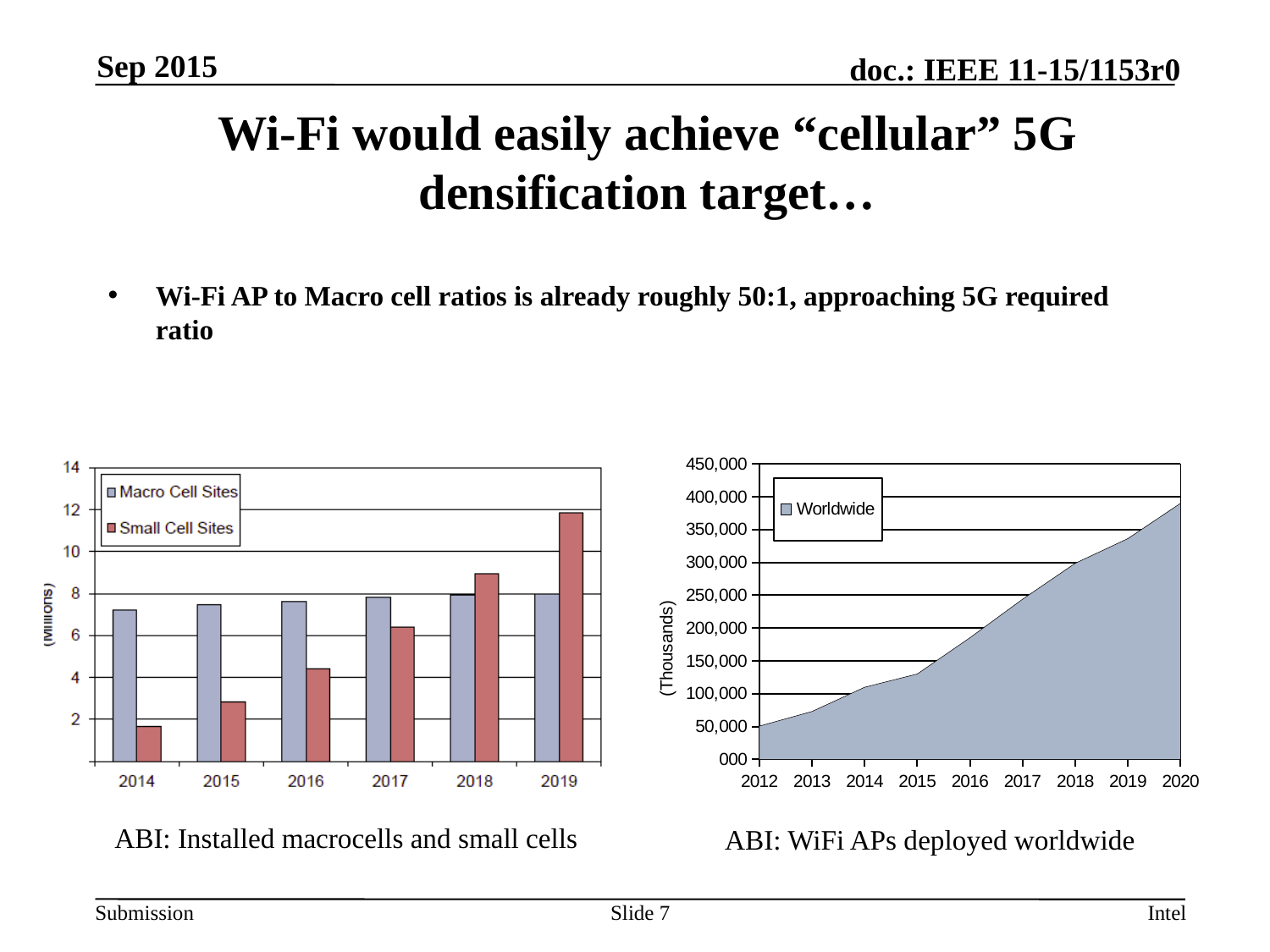
On the left chart (ABI: Installed macrocells and small cells), in 2019, which is larger: Macro Cell Sites or Small Cell Sites? Small Cell Sites What kind of chart is the right chart (ABI: WiFi APs deployed worldwide)? area chart On the right chart (ABI: WiFi APs deployed worldwide), is the value for 2012 greater or less than 100,000? less On the left chart (ABI: Installed macrocells and small cells), in 2017, which is larger: Macro Cell Sites or Small Cell Sites? Macro Cell Sites On the left chart (ABI: Installed macrocells and small cells), in which year are Small Cell Sites highest? 2019 On the left chart (ABI: Installed macrocells and small cells), is the value for Small Cell Sites in 2014 greater or less than 2? less On the left chart (ABI: Installed macrocells and small cells), how many years are shown on the x axis? 6 On the left chart (ABI: Installed macrocells and small cells), how many series does the legend list? 2 On the left chart (ABI: Installed macrocells and small cells), is the value for Small Cell Sites in 2019 greater or less than 10? greater On the left chart (ABI: Installed macrocells and small cells), do the Small Cell Sites values rise or fall from 2014 to 2019? rise On the left chart (ABI: Installed macrocells and small cells), in which year are Small Cell Sites lowest? 2014